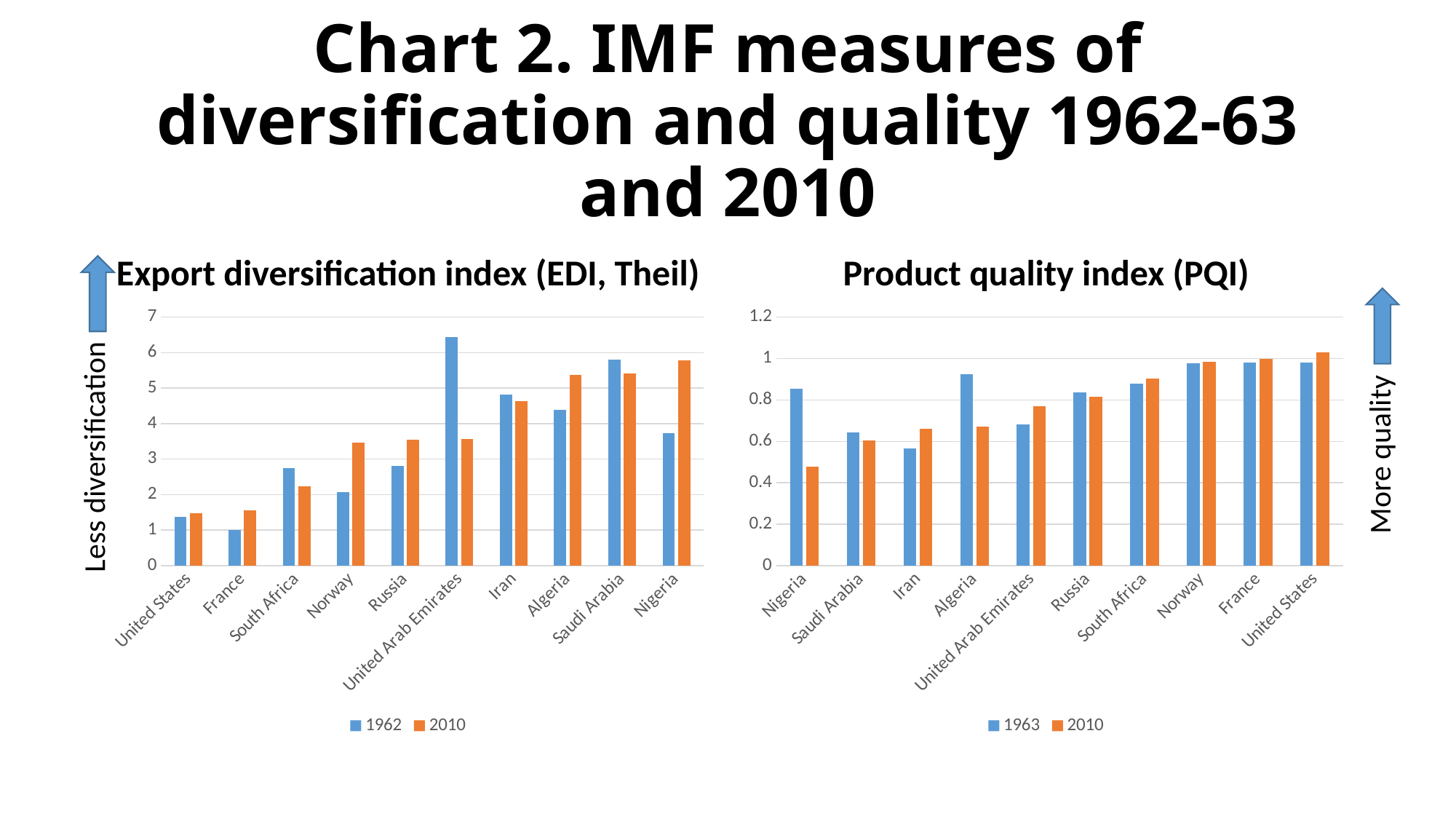
How many series does the legend of the Product quality index (PQI) chart list? 2 In the Product quality index (PQI) chart, which is larger for Nigeria, the 1963 value or the 2010 value? 1963 In the Export diversification index (EDI, Theil) chart, is the 1962 value for France greater or less than 2? less In the Export diversification index (EDI, Theil) chart, which country has the lowest value for 1962? France In the Export diversification index (EDI, Theil) chart, which is larger for United Arab Emirates, the 1962 value or the 2010 value? 1962 In the Export diversification index (EDI, Theil) chart, is the 1962 value for United Arab Emirates greater or less than 6? greater In the Export diversification index (EDI, Theil) chart, which country has the highest value for 2010? Nigeria How many countries are shown in the Export diversification index (EDI, Theil) chart? 10 In the Product quality index (PQI) chart, which country has the lowest value for 1963? Iran In the Export diversification index (EDI, Theil) chart, which country has the highest value for 1962? United Arab Emirates In the Product quality index (PQI) chart, is the 2010 value for Nigeria greater or less than 0.6? less In the Product quality index (PQI) chart, which country has the lowest value for 2010? Nigeria